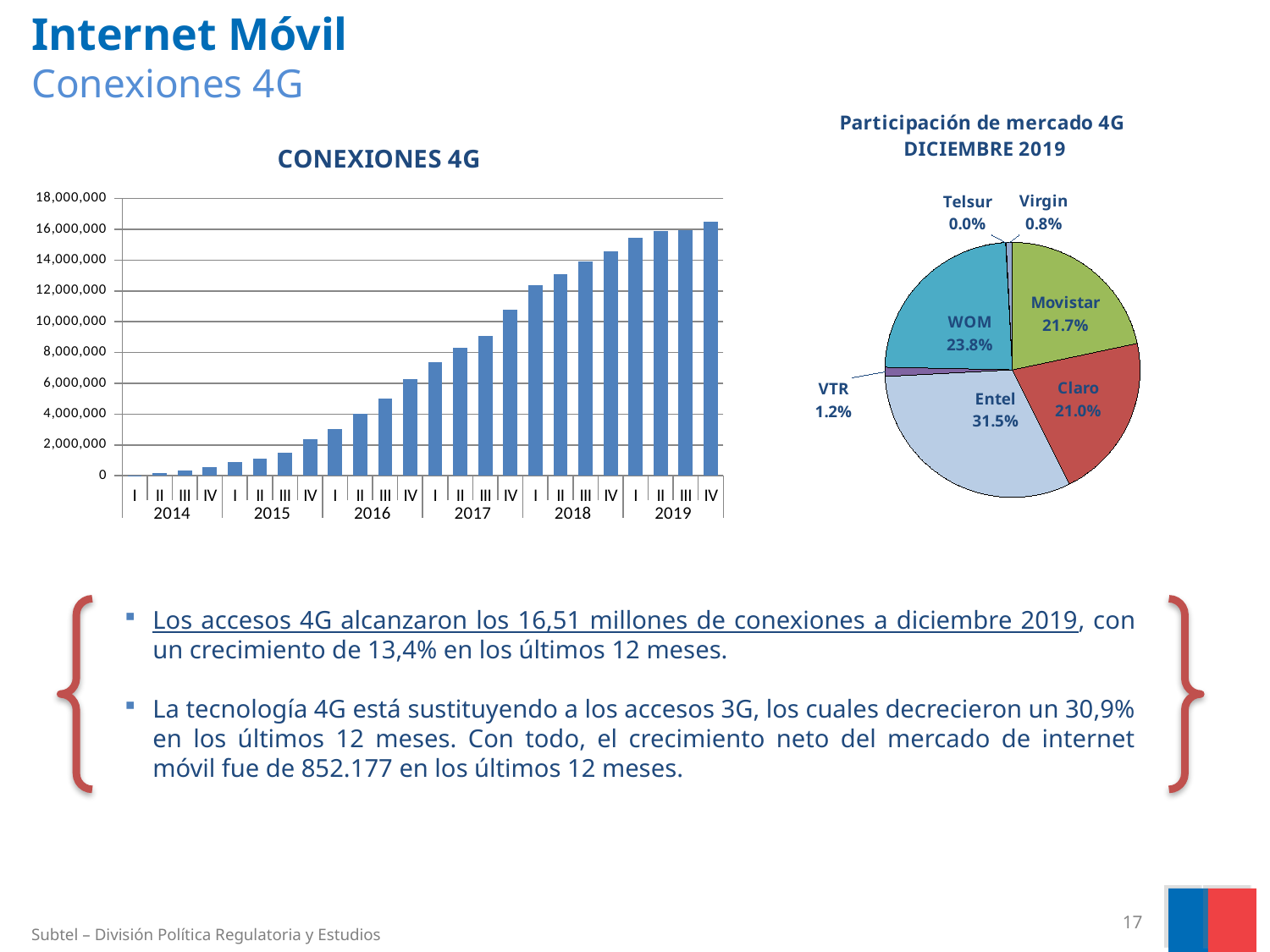
In the 'CONEXIONES 4G' chart, is the value for quarter IV of 2019 greater or less than 14,000,000? greater In the pie chart 'Participación de mercado 4G DICIEMBRE 2019', what is Entel's market share? 31.5% In the 'CONEXIONES 4G' chart, do the values rise or fall from 2014 to 2019? Rise In the pie chart 'Participación de mercado 4G DICIEMBRE 2019', what is WOM's market share? 23.8% In the pie chart 'Participación de mercado 4G DICIEMBRE 2019', what is the difference between Movistar's and Claro's shares? 0.7% In the pie chart 'Participación de mercado 4G DICIEMBRE 2019', which operator has the largest share? Entel How many bars are plotted in the 'CONEXIONES 4G' chart? 24 How many operators are shown in the pie chart 'Participación de mercado 4G DICIEMBRE 2019'? 7 In the pie chart 'Participación de mercado 4G DICIEMBRE 2019', which has a larger share, WOM or Movistar? WOM In the pie chart 'Participación de mercado 4G DICIEMBRE 2019', which operator has the smallest share? Telsur In the 'CONEXIONES 4G' chart, is the value for quarter I of 2017 greater or less than 8,000,000? less What kind of chart is 'CONEXIONES 4G'? Bar chart